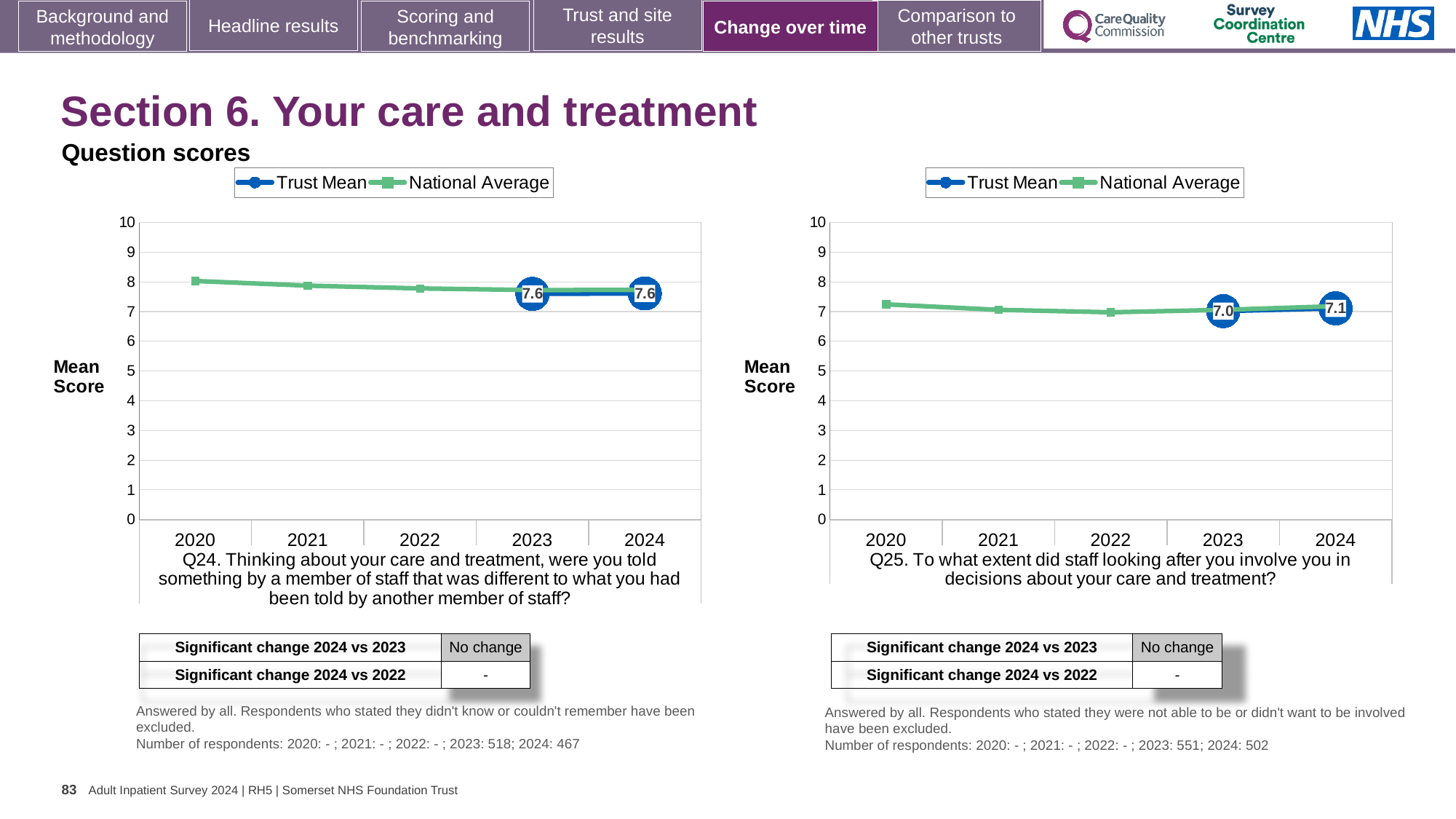
What type of chart is the Q24 chart on the left? line chart In the Q25 chart on the right, what is the Trust Mean score for 2024? 7.1 How many years are shown on the x axis of the Q24 chart on the left? 5 In the Q25 chart on the right, what is the difference between the Trust Mean scores for 2024 and 2023? 0.1 In the Q25 chart on the right, is the National Average for 2020 greater or less than 8? less In the Q25 chart on the right, what is the Trust Mean score for 2023? 7.0 In the Q25 chart on the right, which year has the higher Trust Mean score, 2023 or 2024? 2024 In the Q24 chart on the left, is the National Average for 2020 greater or less than 7? greater How many series does the legend of the Q25 chart on the right list? 2 In the Q24 chart on the left, what is the Trust Mean score for 2024? 7.6 In the Q24 chart on the left, what is the Trust Mean score for 2023? 7.6 In the Q24 chart on the left, does the National Average rise or fall from 2020 to 2024? fall